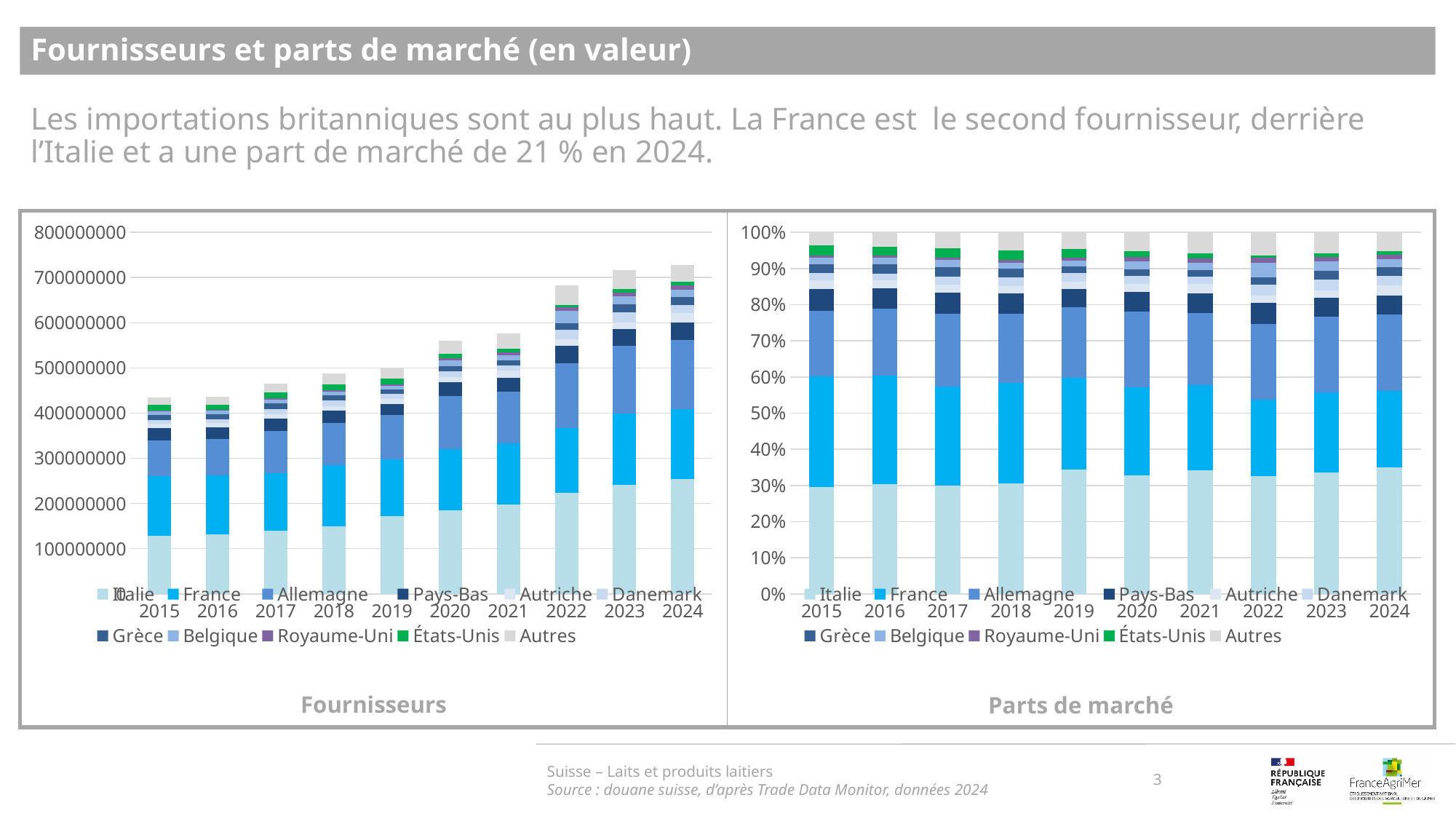
In the 'Parts de marché' chart, which series is at the bottom of each stacked bar? Italie In the 'Fournisseurs' chart, how many years are shown on the x axis? 10 In the 'Fournisseurs' chart, which year has the highest total stacked bar? 2024 In the 'Fournisseurs' chart, do the total stacked values generally rise or fall from 2015 to 2024? rise In the 'Parts de marché' chart, is the share for Italie in 2024 greater or less than 30%? greater In the 'Fournisseurs' chart, which is larger, the total stacked bar for 2024 or for 2015? 2024 In the 'Parts de marché' chart, how many series does the legend list? 11 In the 'Fournisseurs' chart, is the total stacked value for 2024 greater or less than 700000000? greater What kind of chart is the 'Parts de marché' chart on the right? 100% stacked bar chart In the 'Fournisseurs' chart, is the total stacked value for 2015 greater or less than 500000000? less What kind of chart is the 'Fournisseurs' chart on the left? stacked bar chart What is the title of the chart on the right of the slide? Parts de marché